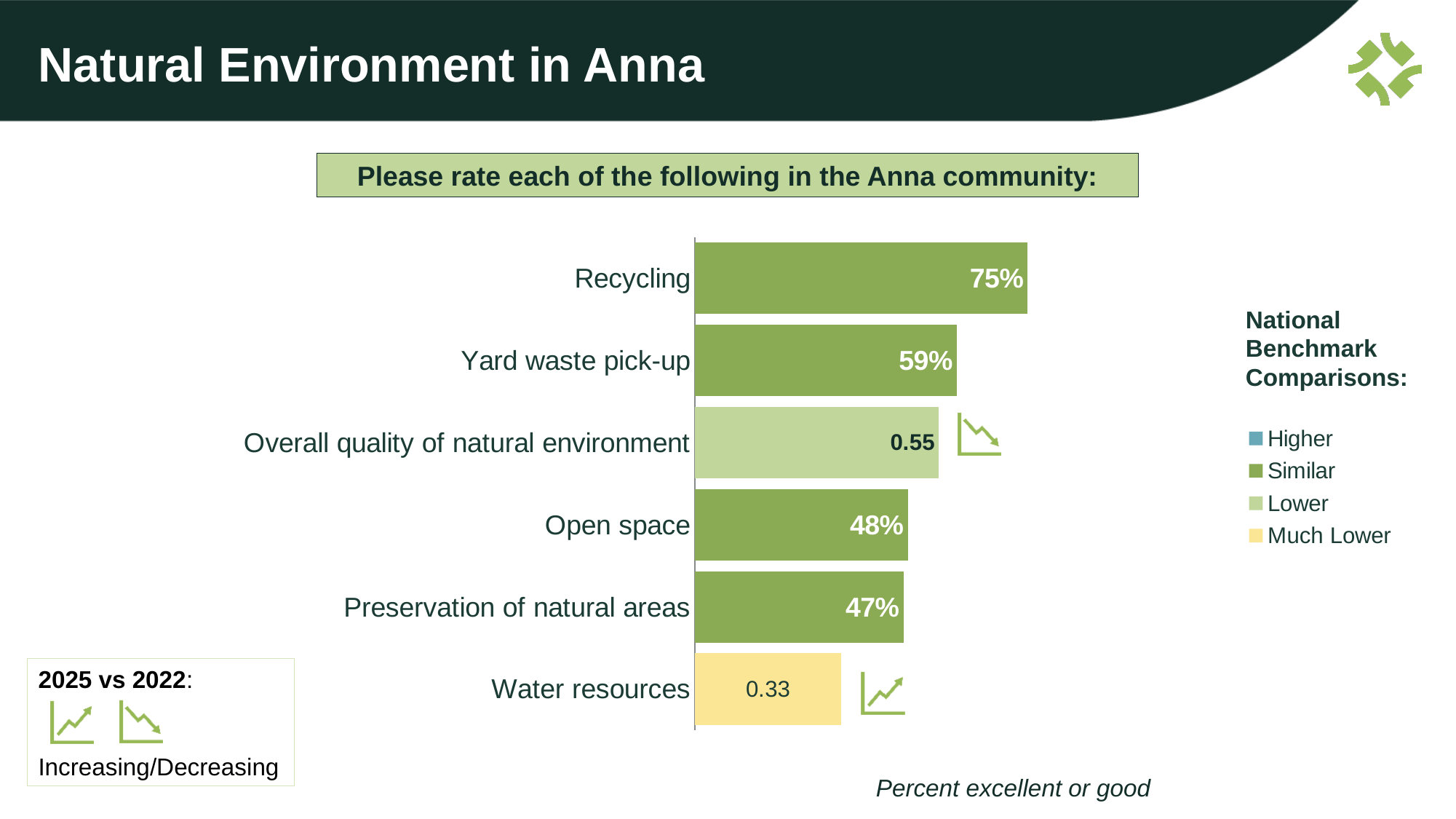
Which category has the highest rating? Recycling Which is larger, the value for Yard waste pick-up or the value for Open space? Yard waste pick-up How many entries does the National Benchmark Comparisons legend list? 4 What value is printed on the bar for Water resources? 0.33 What is the value shown for Preservation of natural areas? 47% What is the value shown for Recycling? 75% What is the difference between the values for Recycling and Yard waste pick-up? 16 percentage points What value is printed on the bar for Overall quality of natural environment? 0.55 How many categories are shown in the chart? 6 What is the value shown for Yard waste pick-up? 59% Which category has the lowest rating? Water resources What kind of chart is shown on the slide? Bar chart